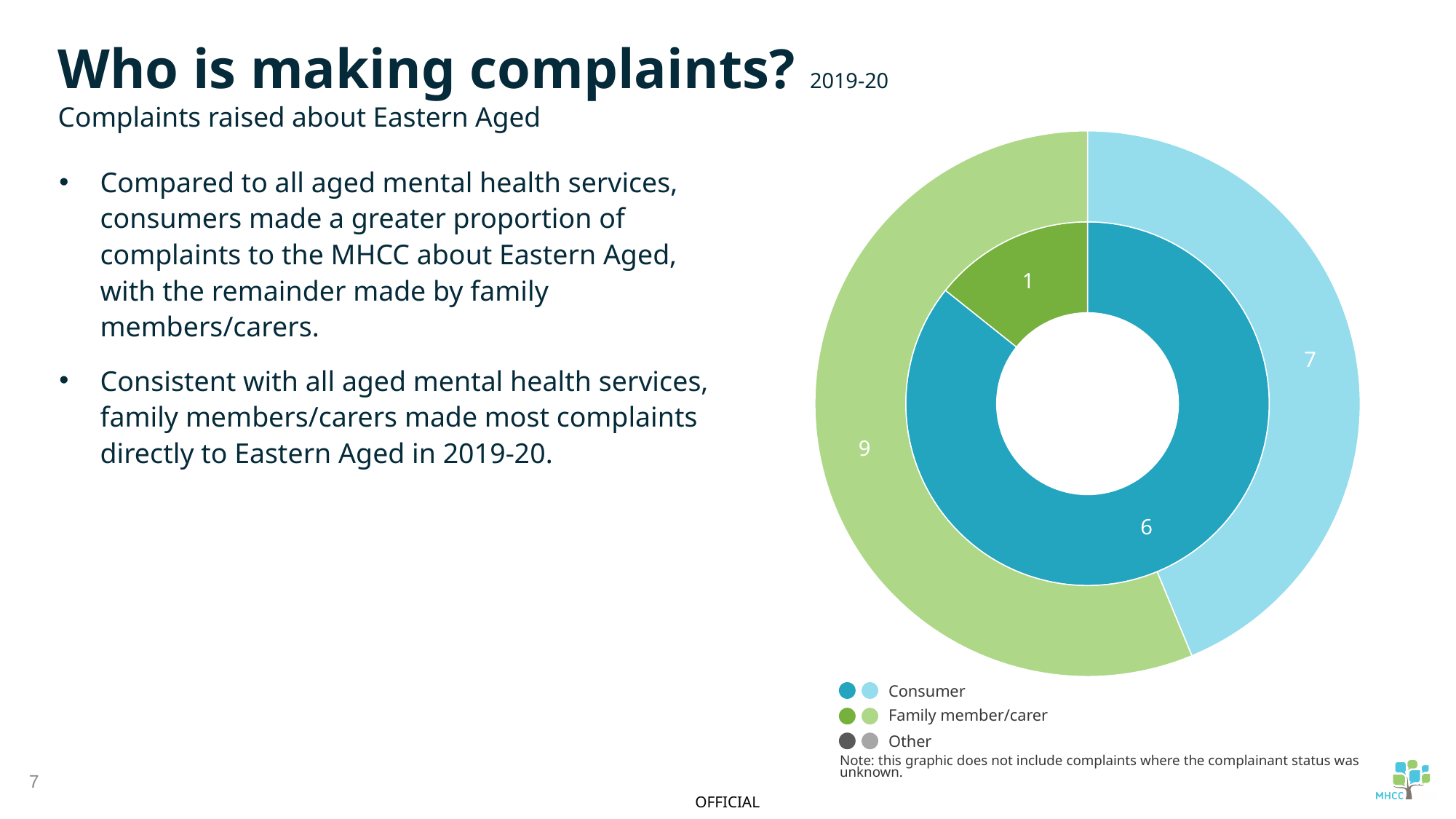
In the inner ring of the doughnut chart, what value is shown for Consumer? 6 What kind of chart is shown on the slide? Doughnut chart In the outer ring of the doughnut chart, what value is shown for Family member/carer? 9 What is the total of the values shown in the outer ring of the doughnut chart? 16 Which category has the largest segment in the outer ring of the doughnut chart? Family member/carer In the inner ring, what is the difference between the Consumer value and the Family member/carer value? 5 Which legend entry of the doughnut chart has no visible segment in either ring? Other How many entries does the legend of the doughnut chart list? 3 In the inner ring of the doughnut chart, what value is shown for Family member/carer? 1 In the outer ring of the doughnut chart, what value is shown for Consumer? 7 Which category has the largest segment in the inner ring of the doughnut chart? Consumer In the outer ring, what is the difference between the Family member/carer value and the Consumer value? 2